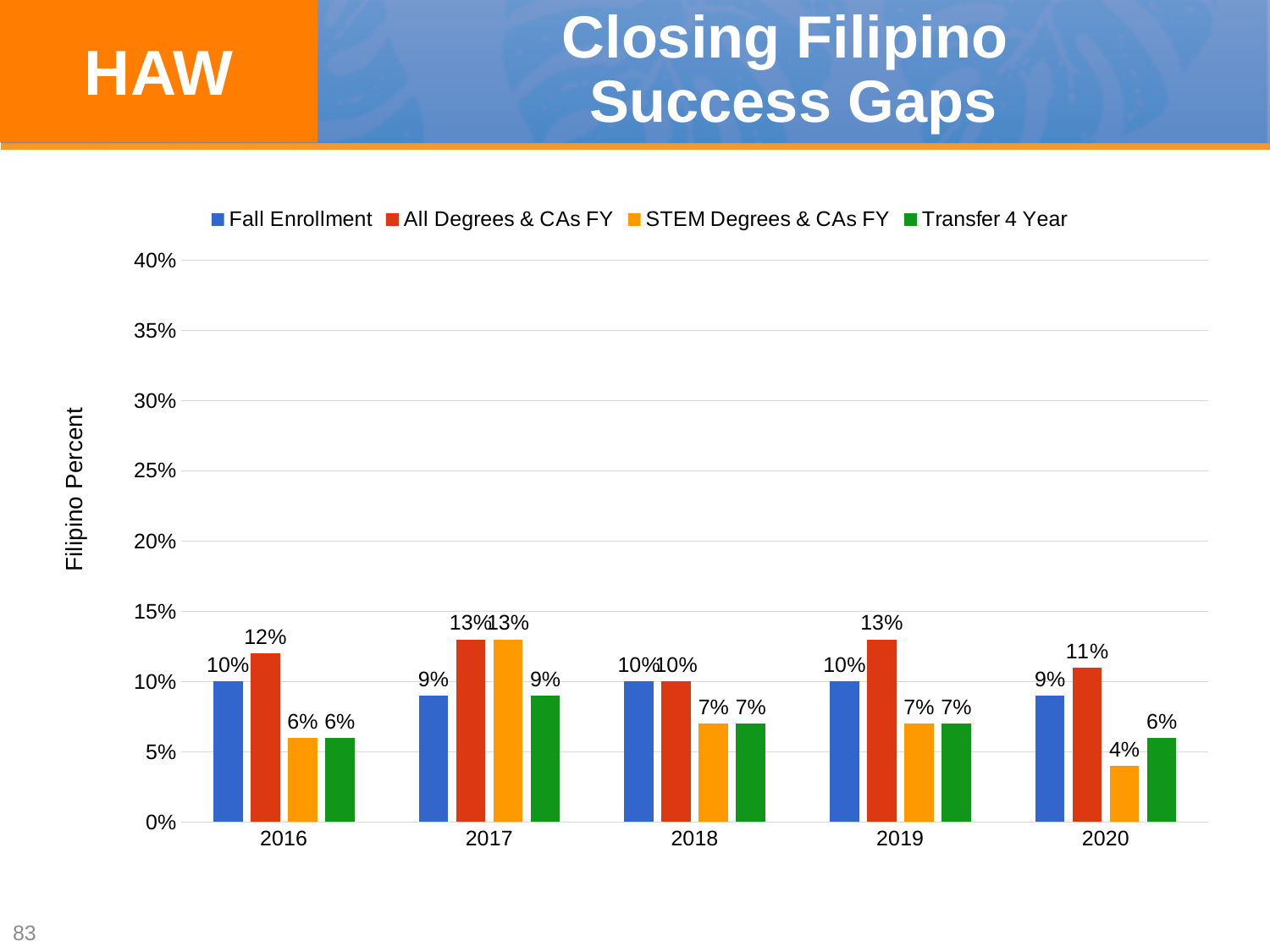
What is the value for Transfer 4 Year in 2017? 9% What kind of chart is shown on the slide? Bar chart What is the value for Fall Enrollment in 2018? 10% How many series does the legend list? 4 Which is larger in 2020, All Degrees & CAs FY or Transfer 4 Year? All Degrees & CAs FY What is the difference between All Degrees & CAs FY and Fall Enrollment in 2019? 3% In which year is the STEM Degrees & CAs FY value highest? 2017 What is the value for All Degrees & CAs FY in 2016? 12% Is the value for All Degrees & CAs FY in 2017 greater or less than 10%? greater How many years are shown on the x axis? 5 In which year is the STEM Degrees & CAs FY value lowest? 2020 What is the value for STEM Degrees & CAs FY in 2020? 4%